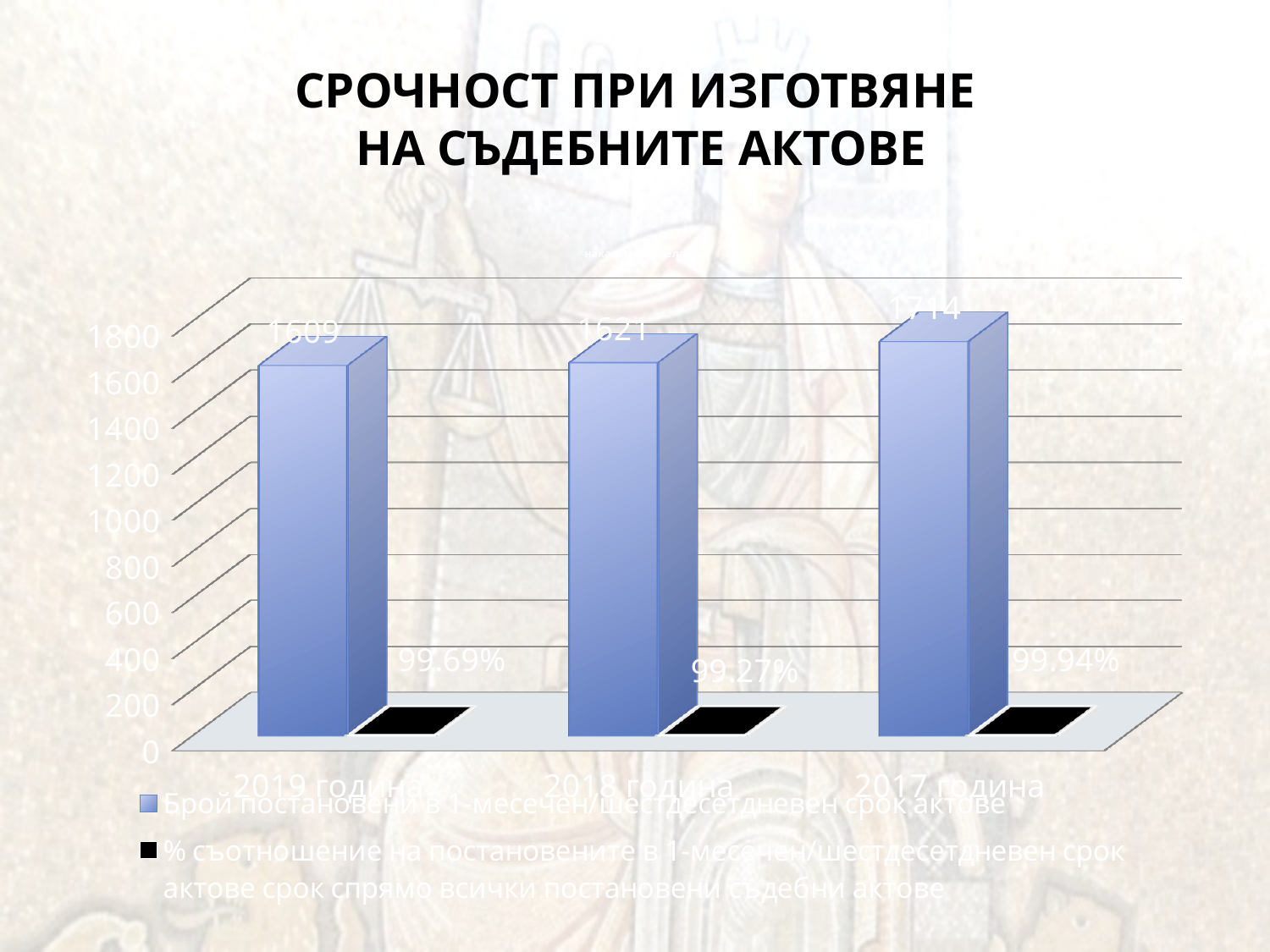
What is the number of acts issued within the 1-month/60-day term (Брой постановени в 1-месечен/шестдесетдневен срок актове) for 2019 година? 1609 Which is larger: the number of acts issued within the term in 2018 година or in 2019 година? 2018 година What percentage share is shown for 2018 година? 99.27% How many series does the legend list? 2 What kind of chart is shown on the slide? Bar chart Which year has the lowest percentage share of acts issued within the term? 2018 година What is the number of acts issued within the 1-month/60-day term for 2017 година? 1714 Which year has the highest number of acts issued within the 1-month/60-day term? 2017 година How many year categories are shown on the x axis? 3 What is the number of acts issued within the 1-month/60-day term for 2018 година? 1621 What is the difference between the number of acts issued within the term in 2017 година and in 2019 година? 105 What percentage share is shown for 2017 година? 99.94%